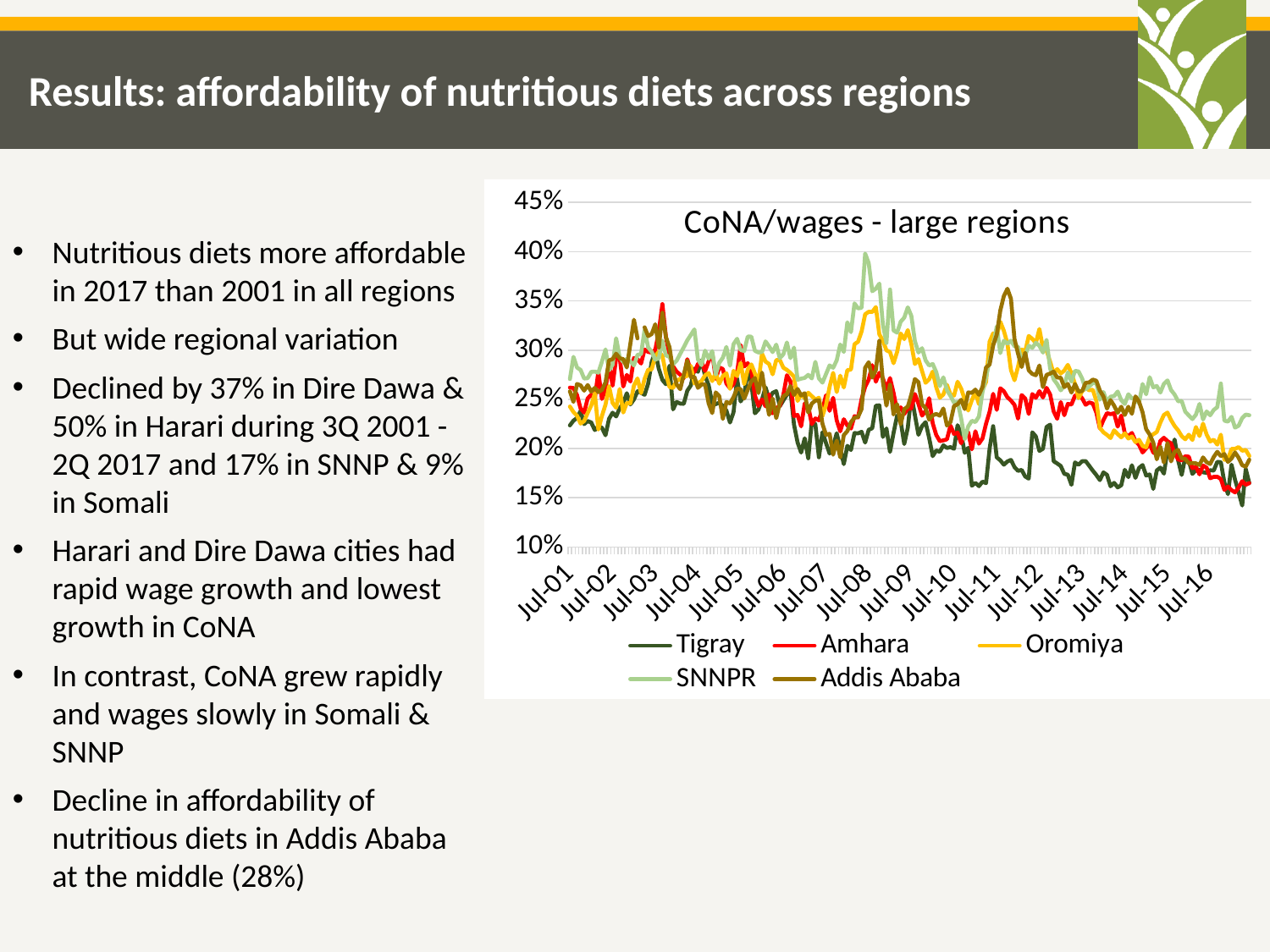
What is the title of the chart? CoNA/wages - large regions Which colour is used for the Amhara series in the chart? red How many series does the legend of the chart list? 5 How many year labels (Jul-01 to Jul-16) are shown on the x axis of the chart? 16 Which series is lowest around Jul-14 on the chart? Tigray Is the peak value for Addis Ababa around Jul-11 greater or less than 30%? greater Around Jul-08, which series has the larger value, SNNPR or Tigray? SNNPR Does the Tigray series generally rise or fall from Jul-01 to Jul-16? fall Is the peak value for SNNPR around Jul-08 greater or less than 35%? greater What kind of chart is shown on the slide? line chart Which series reaches the highest peak on the chart? SNNPR Is the value for Tigray around Jul-14 greater or less than 20%? less